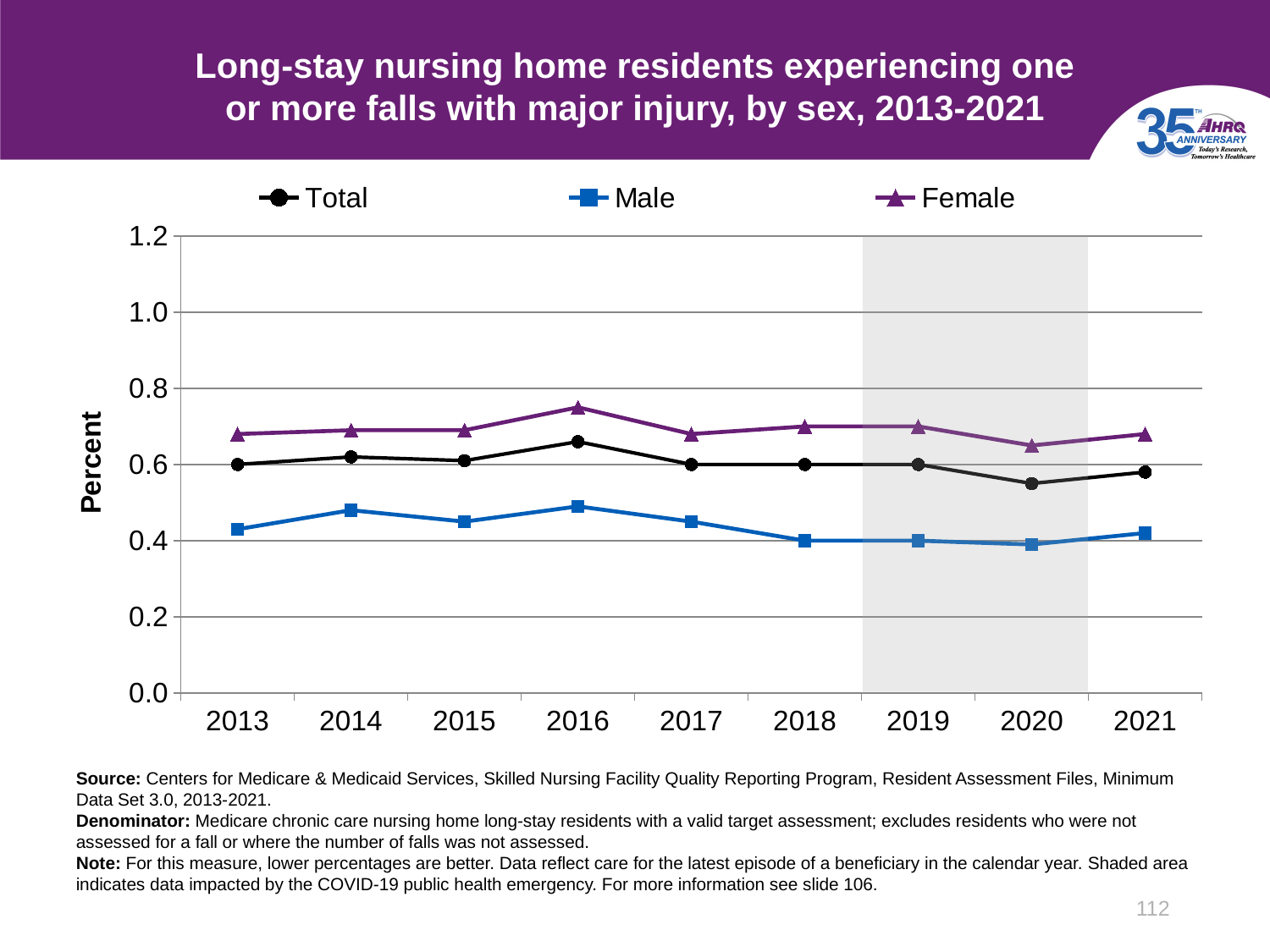
In which year is the Total series at its highest? 2016 How many years are plotted along the x axis? 9 Does the Male series rise or fall from 2016 to 2018? Fall In which year is the Female series at its lowest? 2020 Is the value for Male in 2013 greater or less than 0.6? less What kind of chart is shown on the slide? Line chart How many series does the legend list? 3 What is the label on the y axis? Percent Is the value for Male in 2014 greater or less than 0.4? greater In 2016, which is larger, the Female value or the Male value? Female In which year is the Female series at its highest? 2016 Is the value for Female in 2016 greater or less than 0.6? greater